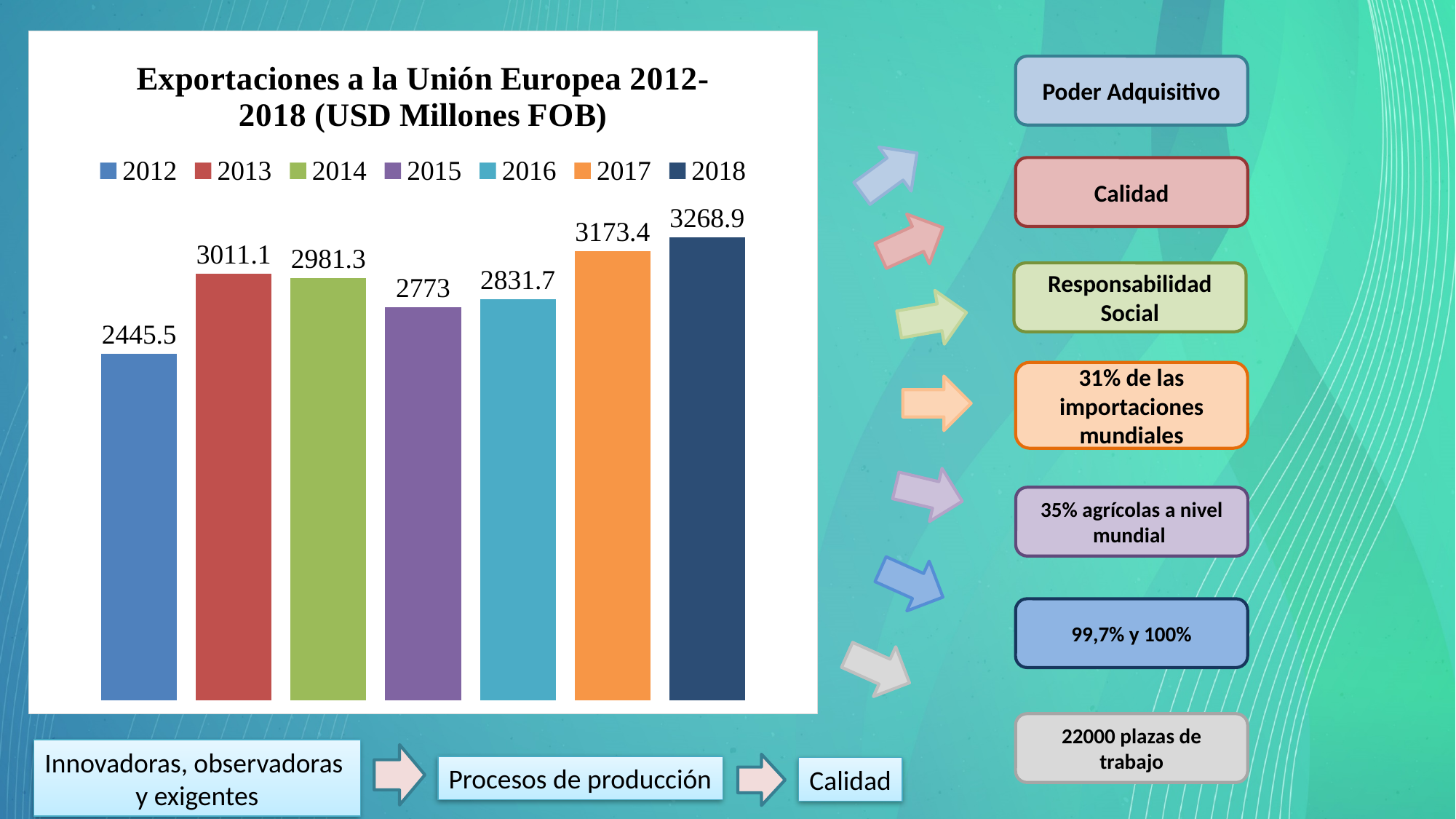
What is the difference between the values for 2018 and 2012? 823.4 How many entries does the chart's legend list? 7 What is the value for 2015 in the chart? 2773 Does the value rise or fall from 2016 to 2017? Rise Which is larger, the value for 2016 or the value for 2015? 2016 How many bars are plotted in the chart? 7 Which year has the lowest value in the chart? 2012 What is the value for 2012 in the chart 'Exportaciones a la Unión Europea 2012-2018 (USD Millones FOB)'? 2445.5 What is the difference between the values for 2013 and 2014? 29.8 What is the value for 2017 in the chart? 3173.4 What kind of chart is shown on the slide? Bar chart Which year has the highest value in the chart? 2018